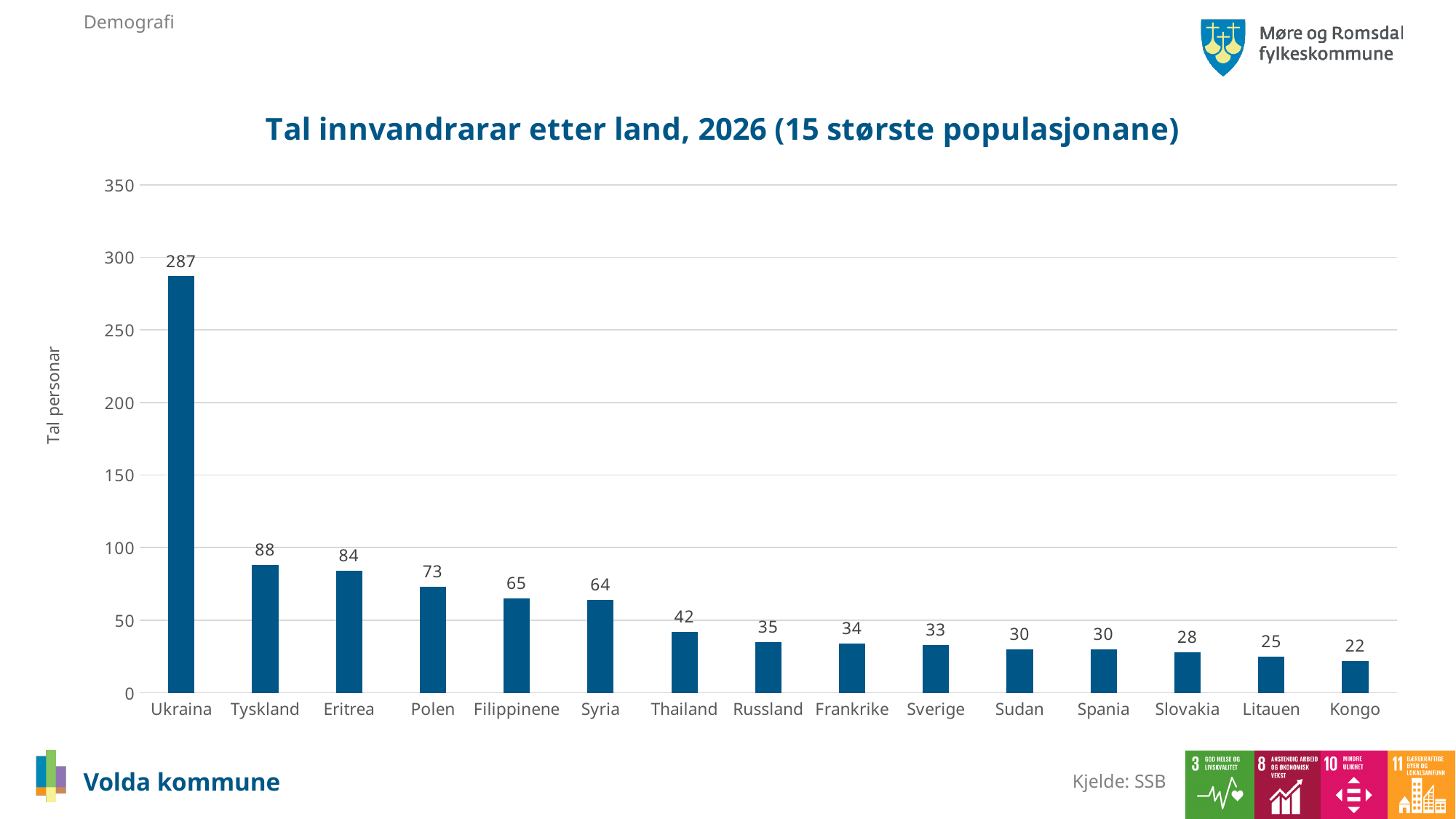
What kind of chart is this? Bar chart Which country has the lowest value? Kongo What is the value for Ukraina? 287 Which country has the highest value? Ukraina Which is larger, the value for Filippinene or the value for Russland? Filippinene Do the values rise or fall from left to right along the x axis? Fall How many countries are shown on the x axis? 15 What is the difference between the values for Ukraina and Kongo? 265 What is the value for Thailand? 42 What is the difference between the values for Tyskland and Eritrea? 4 What is the title of the chart? Tal innvandrarar etter land, 2026 (15 største populasjonane) What is the value for Polen? 73